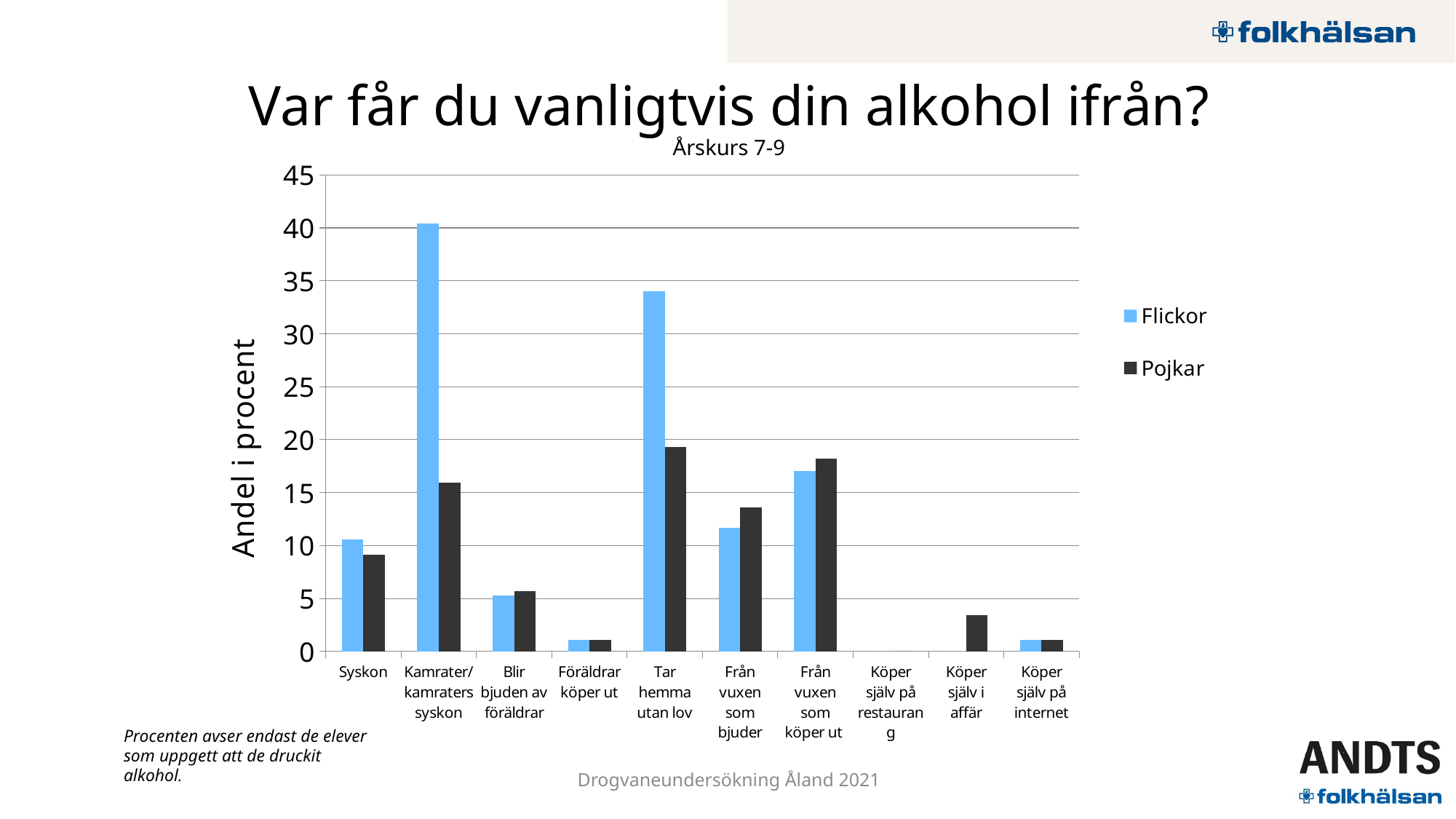
Which category has the highest value for Pojkar? Tar hemma utan lov How many categories are shown on the x axis? 10 Is the Flickor value for Kamrater/kamraters syskon greater or less than 35? greater Which category has the highest value for Flickor? Kamrater/kamraters syskon For Från vuxen som bjuder, which series has the larger value, Flickor or Pojkar? Pojkar How many series does the legend list? 2 What is the title of the y axis? Andel i procent Is the Pojkar value for Köper själv i affär greater or less than 5? less Is the Flickor value for Tar hemma utan lov greater or less than 30? greater For Syskon, which series has the larger value, Flickor or Pojkar? Flickor What kind of chart is shown on the slide? bar chart What colour represents Flickor in the legend? light blue